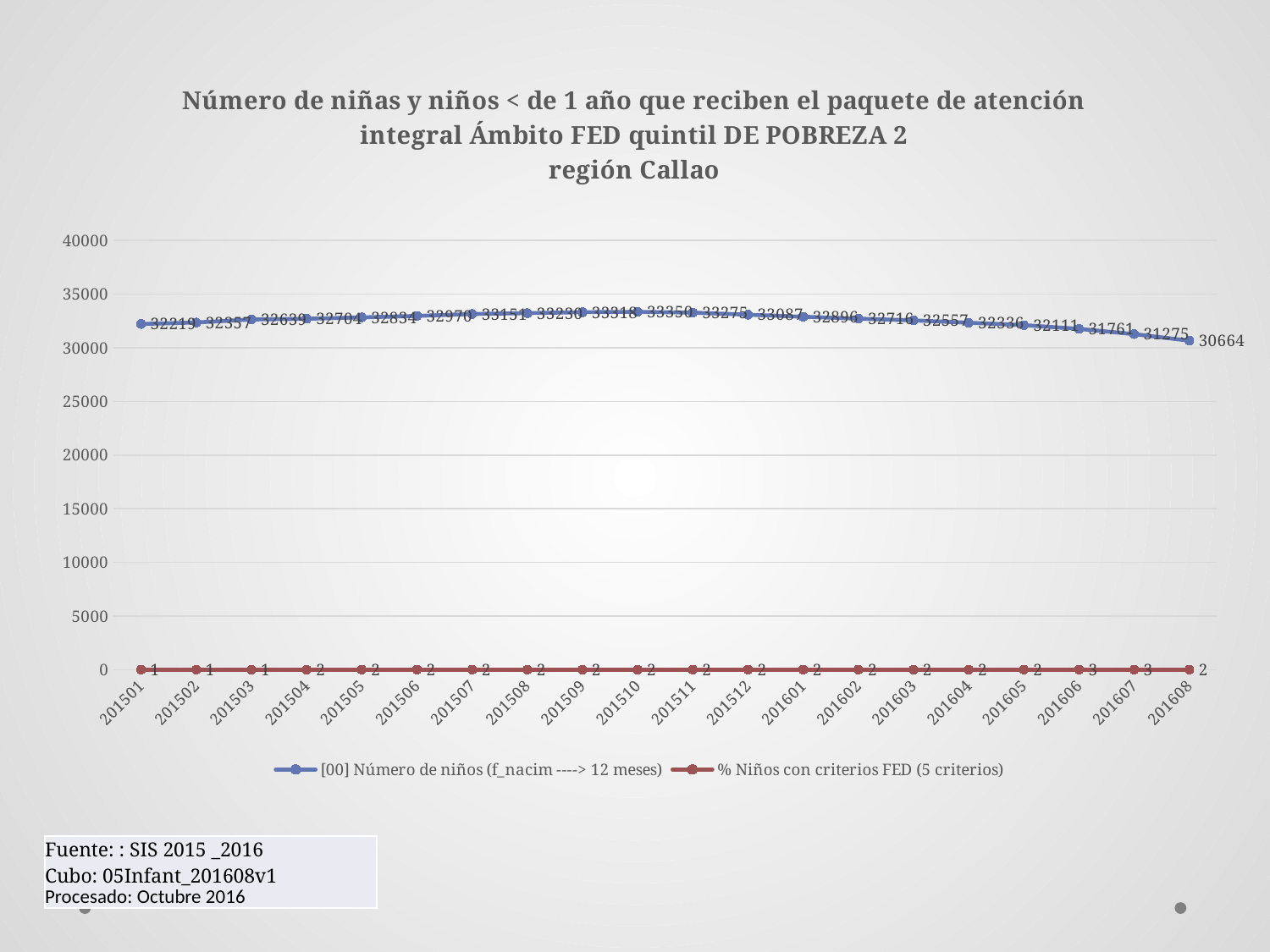
What is the value of '[00] Número de niños (f_nacim ----> 12 meses)' for 201608? 30664 What is the value of '% Niños con criterios FED (5 criterios)' for 201606? 3 Which month has the larger '[00] Número de niños' value, 201501 or 201608? 201501 In which month does the '[00] Número de niños' series reach its lowest value? 201608 What is the difference between the '[00] Número de niños' values for 201501 and 201608? 1555 In which month does the '[00] Número de niños' series reach its highest value? 201510 What type of chart is shown on the slide? line chart Does the '[00] Número de niños' series rise or fall from 201510 to 201608? fall What is the value of '[00] Número de niños (f_nacim ----> 12 meses)' for 201501? 32219 How many series does the legend list? 2 Is the '[00] Número de niños' value for 201608 greater or less than 35000? less How many months (points) are plotted along the x axis? 20